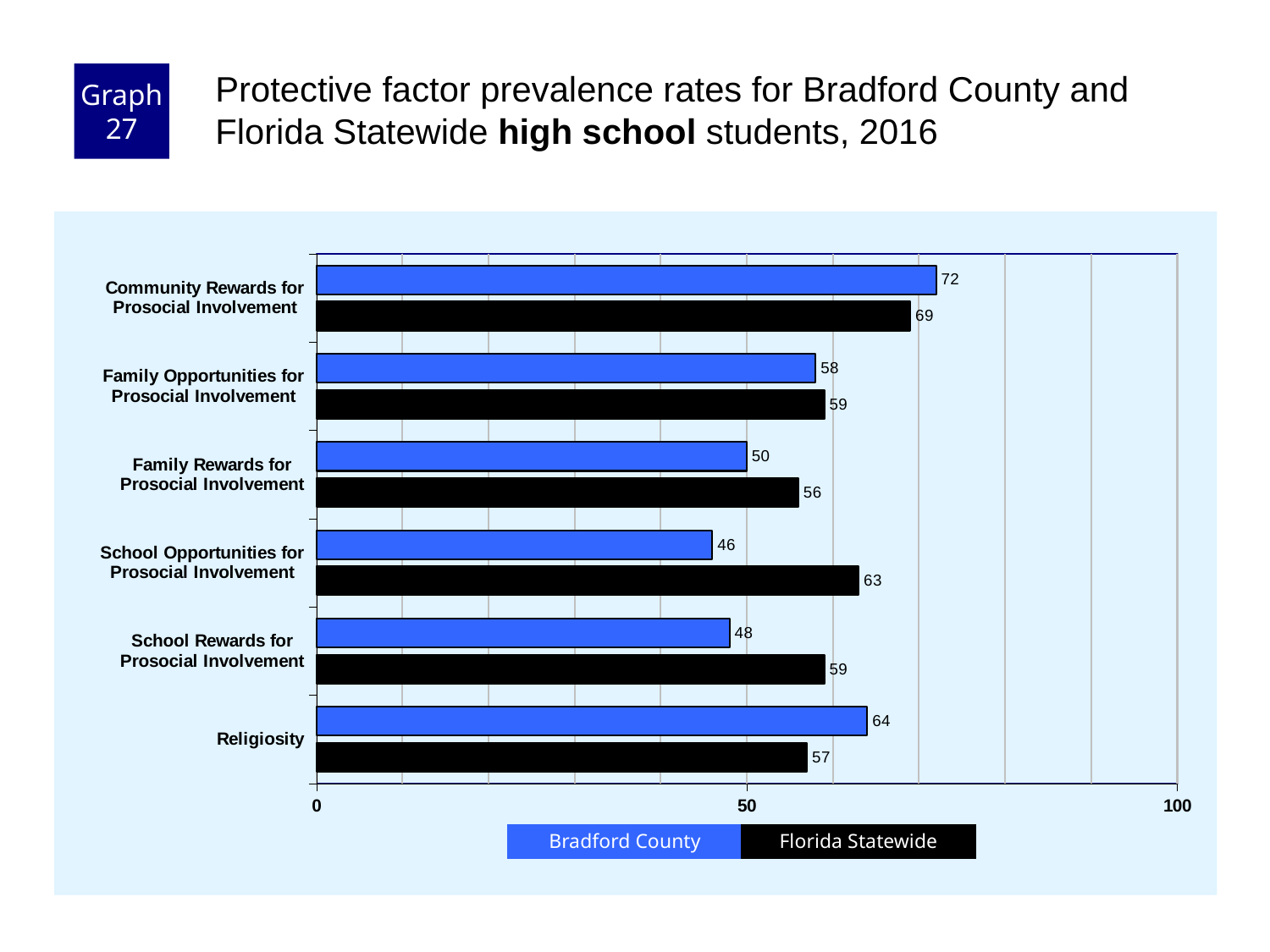
How many categories are shown on the chart? 6 What is the Florida Statewide value for School Opportunities for Prosocial Involvement? 63 Which category has the lowest Bradford County value? School Opportunities for Prosocial Involvement Is the Bradford County value for Family Rewards for Prosocial Involvement greater or less than 50? It equals 50 How many series does the legend list? 2 What is the Bradford County value for Religiosity? 64 What is the Bradford County value for Community Rewards for Prosocial Involvement? 72 Which is larger for Religiosity, the Bradford County value or the Florida Statewide value? Bradford County Which colour represents Florida Statewide in the chart? Black What is the difference between the Florida Statewide and Bradford County values for School Opportunities for Prosocial Involvement? 17 Which category has the highest Bradford County value? Community Rewards for Prosocial Involvement What kind of chart is shown on the slide? Bar chart